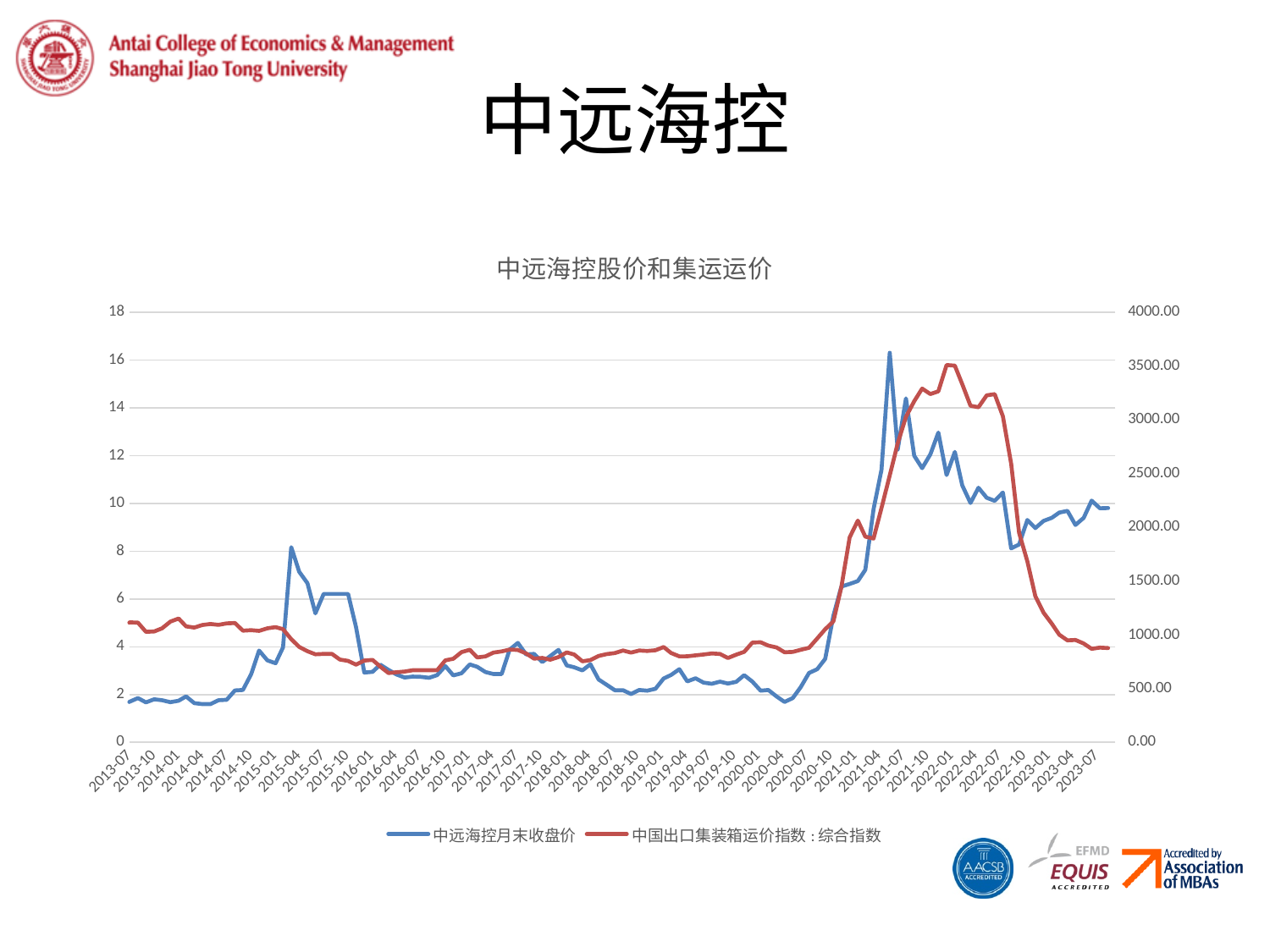
Is the value of 中国出口集装箱运价指数：综合指数 at 2022-01 greater or less than 3000.00? greater What kind of chart is shown on the slide? line chart How many series does the legend list? 2 Between 2022-04 and 2023-01, does the 中国出口集装箱运价指数：综合指数 line rise or fall? fall In which year does the 中远海控月末收盘价 line reach its highest point? 2021 Is the value of 中远海控月末收盘价 at 2021-07 greater or less than 14? less Which series is drawn in red according to the legend? 中国出口集装箱运价指数：综合指数 Is the value of 中国出口集装箱运价指数：综合指数 at 2023-07 greater or less than 1500.00? less What is the title of the chart? 中远海控股价和集运运价 Between 2020-04 and 2021-07, does the 中远海控月末收盘价 line rise or fall? rise